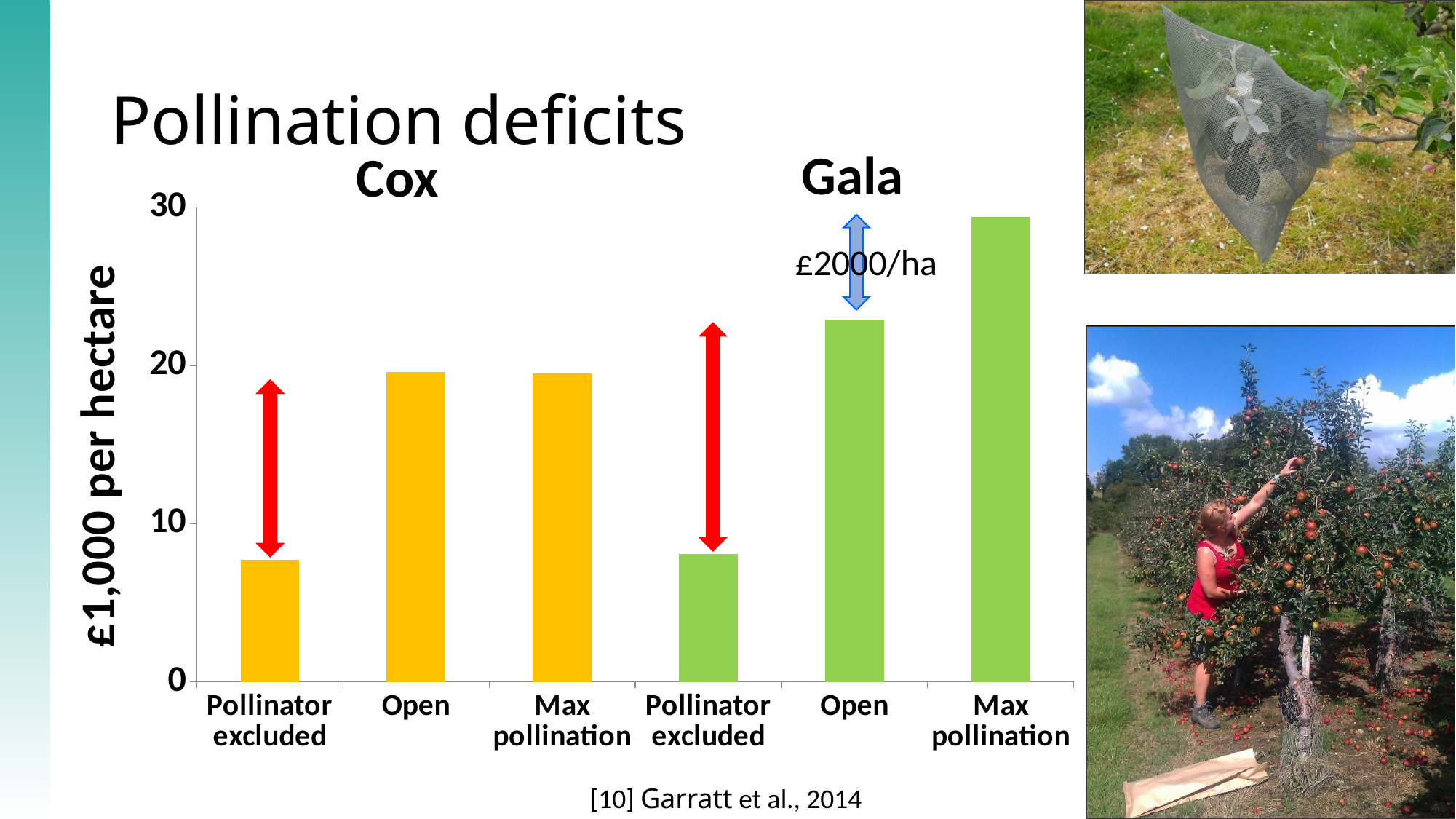
What kind of chart is shown on the slide? bar chart Is the value for Cox Pollinator excluded greater or less than 10? less Which is larger, the Open value for Cox or the Open value for Gala? Gala Open Is the value for Gala Pollinator excluded greater or less than 10? less Which is larger for Gala, Open or Max pollination? Max pollination Is the value for Cox Open greater or less than 10? greater Which bar has the highest value in the chart? Gala Max pollination What is the label on the vertical axis of the chart? £1,000 per hectare How many bars are plotted in the chart? 6